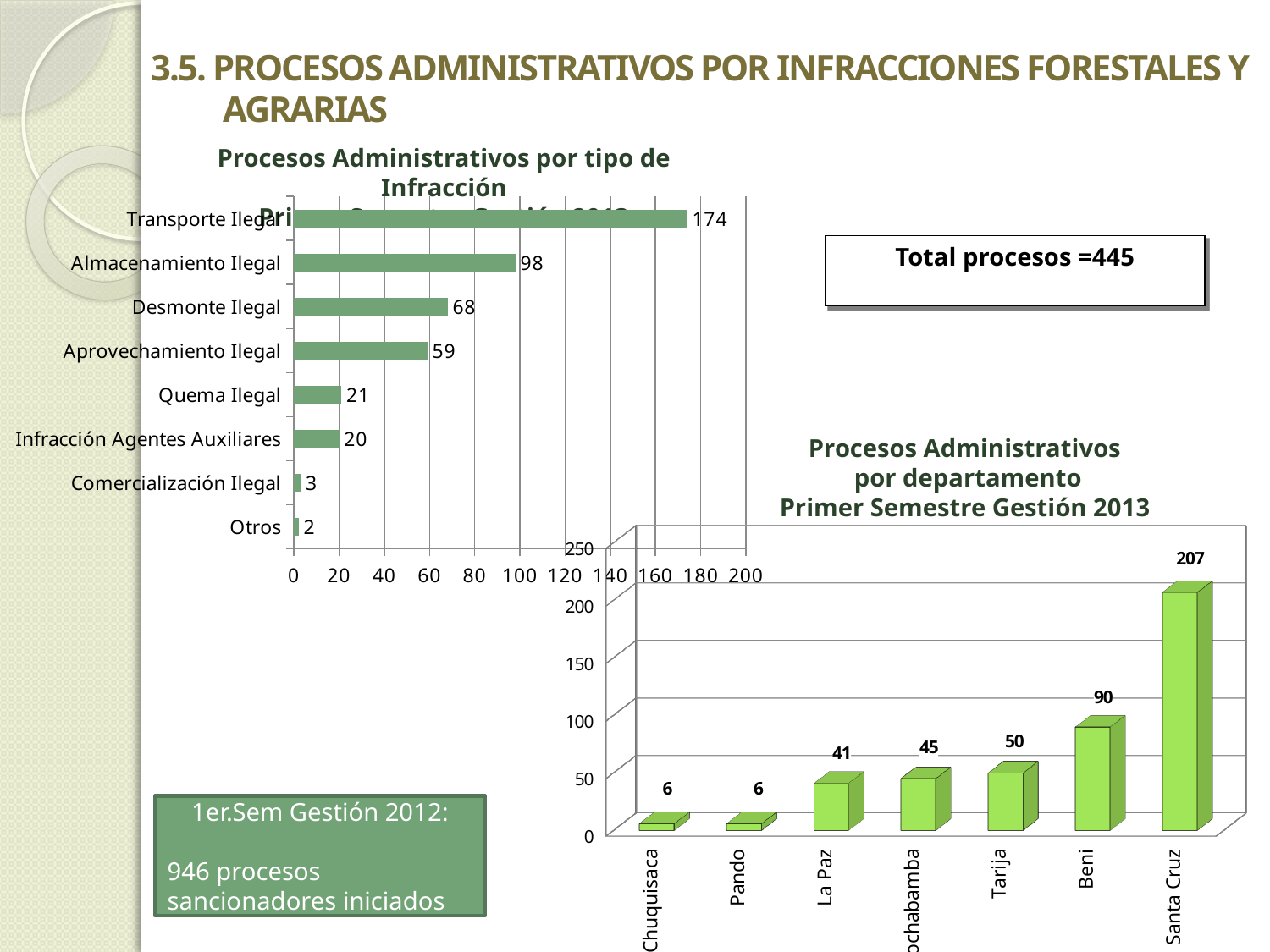
In the 'Procesos Administrativos por departamento' chart, what is the difference between Santa Cruz and Beni? 117 In the 'Procesos Administrativos por tipo de Infracción' chart, which is larger, Quema Ilegal or Infracción Agentes Auxiliares? Quema Ilegal In the 'Procesos Administrativos por tipo de Infracción' chart, which category has the lowest value? Otros In the 'Procesos Administrativos por tipo de Infracción' chart, what is the value for Transporte Ilegal? 174 In the 'Procesos Administrativos por tipo de Infracción' chart, what is the difference between Almacenamiento Ilegal and Aprovechamiento Ilegal? 39 In the 'Procesos Administrativos por departamento' chart, how many departments are shown? 7 In the 'Procesos Administrativos por departamento' chart, what is the value for Santa Cruz? 207 What kind of chart is the 'Procesos Administrativos por departamento' chart? Bar chart In the 'Procesos Administrativos por departamento' chart, which department has the highest value? Santa Cruz In the 'Procesos Administrativos por departamento' chart, what is the value for Beni? 90 In the 'Procesos Administrativos por tipo de Infracción' chart, what is the value for Desmonte Ilegal? 68 In the 'Procesos Administrativos por tipo de Infracción' chart, how many categories are shown? 8